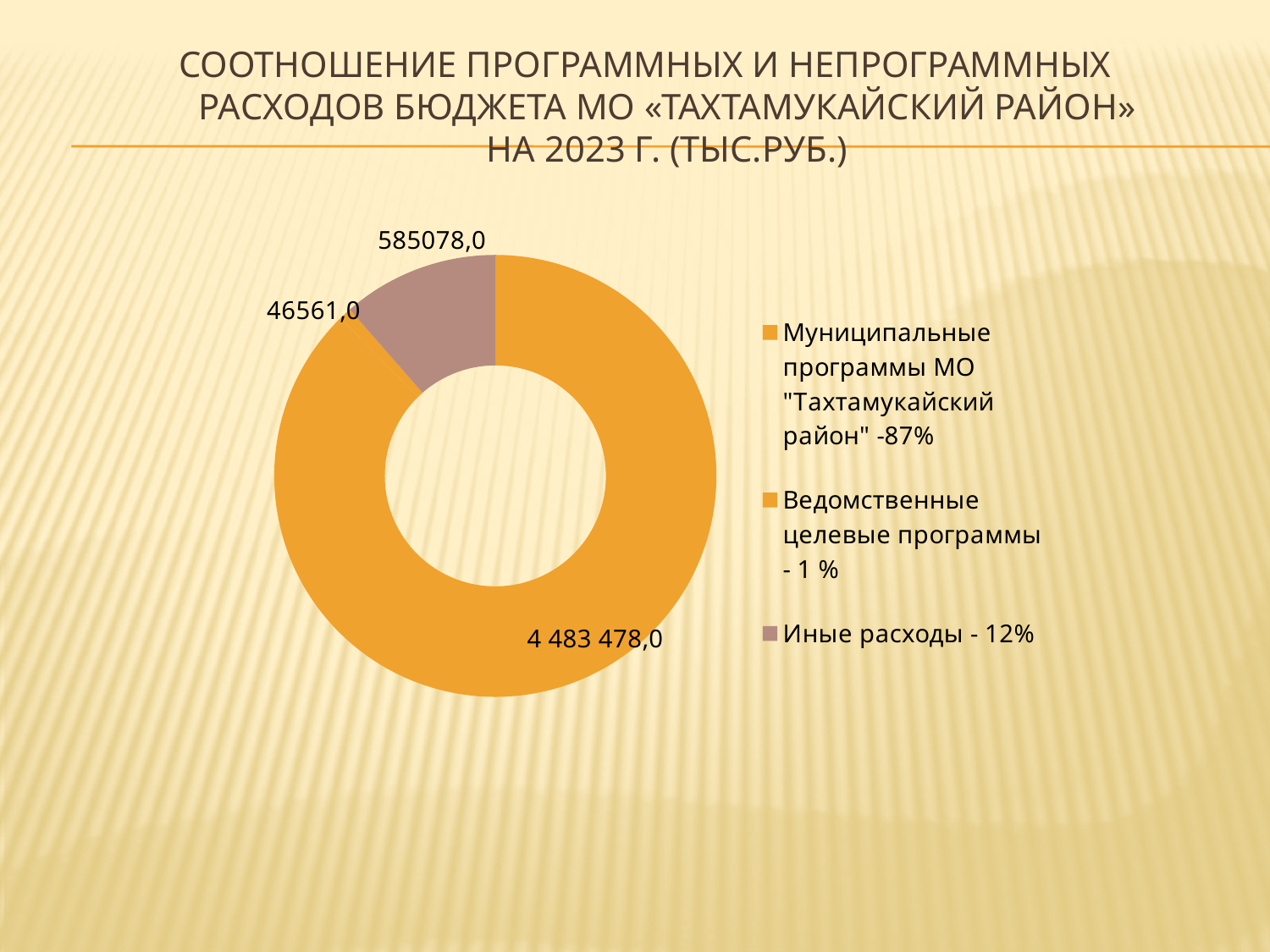
Which category has the largest value? Муниципальные программы МО "Тахтамукайский район" Which is larger: the value for Иные расходы or the value for Ведомственные целевые программы? Иные расходы What share of the total do Муниципальные программы МО "Тахтамукайский район" represent according to the legend? 87% What colour is the slice for Иные расходы? Brownish pink What kind of chart is shown on the slide? Doughnut chart What is the value for Муниципальные программы МО "Тахтамукайский район"? 4 483 478,0 What is the difference between the values for Иные расходы and Ведомственные целевые программы? 538517,0 What is the value for Иные расходы? 585078,0 What share of the total do Иные расходы represent according to the legend? 12% How many categories does the chart show? 3 What is the value for Ведомственные целевые программы? 46561,0 Which category has the smallest value? Ведомственные целевые программы